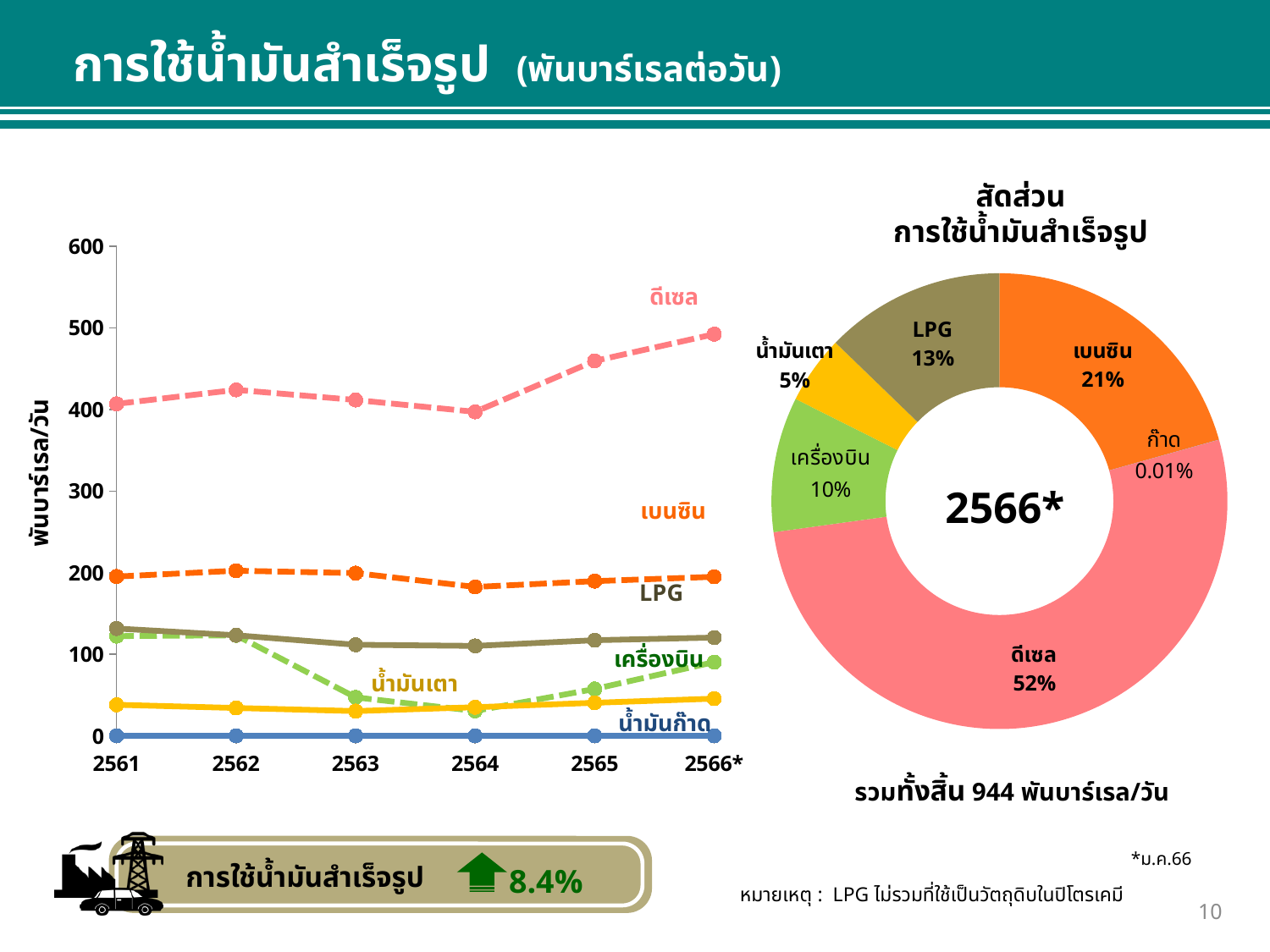
In the line chart on the left, is the value for เครื่องบิน in 2563 greater or less than 100? less In the donut chart on the right, which has the larger share, เครื่องบิน or น้ำมันเตา? เครื่องบิน In the donut chart on the right, which category has the largest share? ดีเซล How many slices does the donut chart on the right have? 6 How many series are plotted in the line chart on the left? 6 In the line chart on the left, is the value for ดีเซล in 2566* greater or less than 400? greater How many years are shown on the x axis of the line chart on the left? 6 What kind of chart is the chart on the left of the slide? Line chart In the donut chart on the right, what is the difference between the shares of เบนซิน and LPG? 8% In the donut chart on the right, which category has the smallest share? ก๊าด In the line chart on the left, does the ดีเซล line rise or fall from 2564 to 2566*? rises In the donut chart titled สัดส่วนการใช้น้ำมันสำเร็จรูป, what share does ดีเซล have? 52%